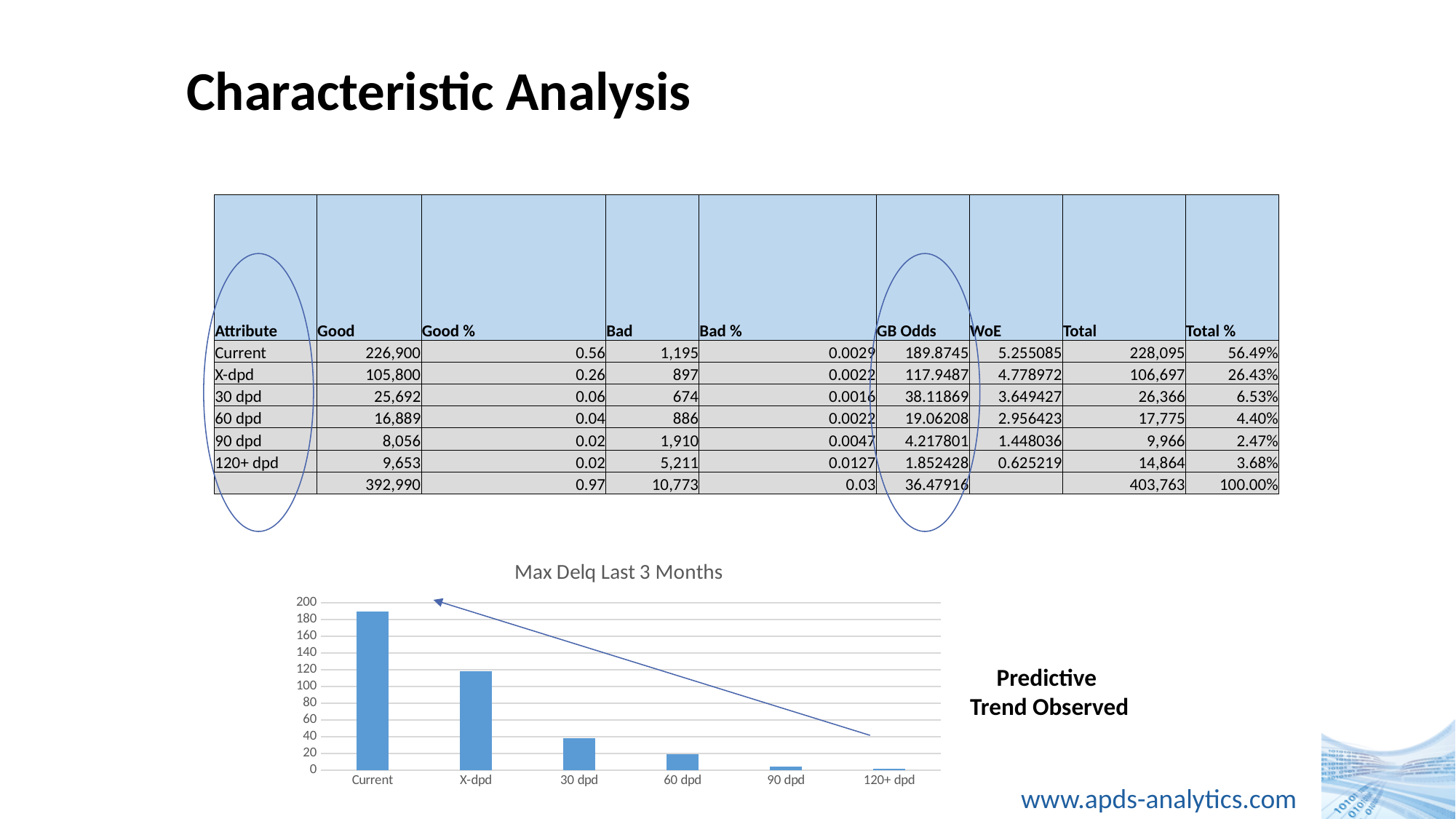
Do the bars in the "Max Delq Last 3 Months" chart rise or fall from left to right along the x axis? fall What is the title of the chart on the slide? Max Delq Last 3 Months In the "Max Delq Last 3 Months" chart, is the value for 90 dpd greater or less than 20? less In the "Max Delq Last 3 Months" chart, is the value for 30 dpd greater or less than 60? less Which category has the lowest bar in the "Max Delq Last 3 Months" chart? 120+ dpd What kind of chart is shown under the title "Max Delq Last 3 Months"? bar chart In the "Max Delq Last 3 Months" chart, which is larger, the bar for X-dpd or the bar for 60 dpd? X-dpd Which category has the highest bar in the "Max Delq Last 3 Months" chart? Current In the "Max Delq Last 3 Months" chart, is the value for Current greater or less than 180? greater What is the highest tick value shown on the y axis of the "Max Delq Last 3 Months" chart? 200 How many categories are plotted on the x axis of the "Max Delq Last 3 Months" chart? 6